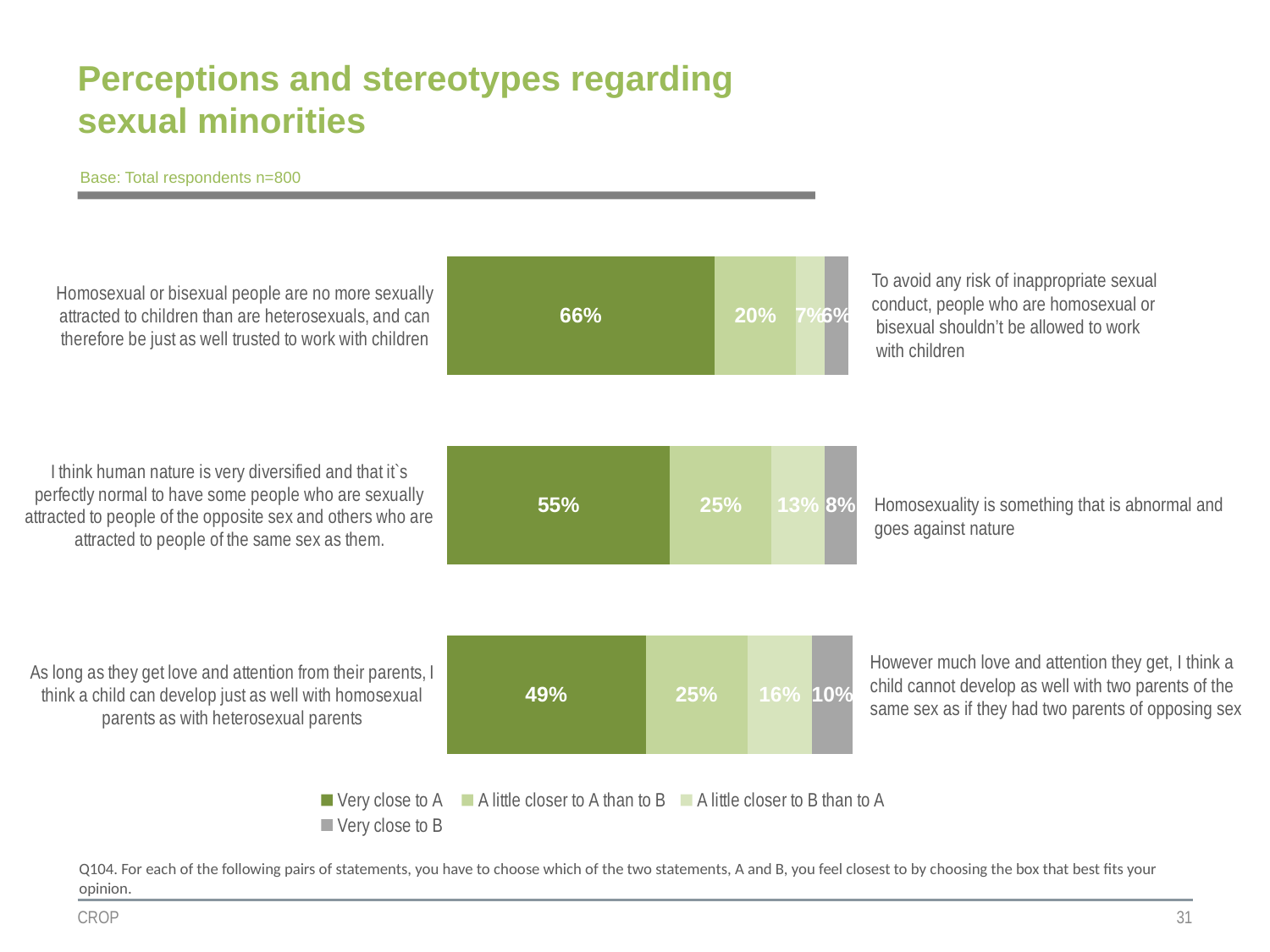
Which statement pair has the highest "Very close to A" percentage? Homosexual or bisexual people are no more sexually attracted to children than are heterosexuals (66%) How many series does the legend list? 4 Which is larger: the "Very close to B" share for the human nature statement pair or for the child development statement pair? The child development pair (10%) How many statement pairs (bars) are plotted in the chart? 3 What percentage were "A little closer to B than to A" for the pair about human nature being diversified versus homosexuality being abnormal? 13% Which statement pair has the lowest "Very close to A" percentage? As long as they get love and attention from their parents, a child can develop just as well with homosexual parents (49%) What kind of chart is shown on the slide? Stacked bar chart What percentage were "Very close to B" for the pair about whether a child can develop just as well with homosexual parents? 10% What percentage of respondents were "Very close to A" for the statement that homosexual or bisexual people can be just as well trusted to work with children? 66% What is the total of the segments in the bar for the human nature statement pair (55%, 25%, 13%, 8%)? 101% Which legend entry is shown in grey? Very close to B What is the difference between the "Very close to A" percentages for the first bar (66%) and the third bar (49%)? 17 percentage points